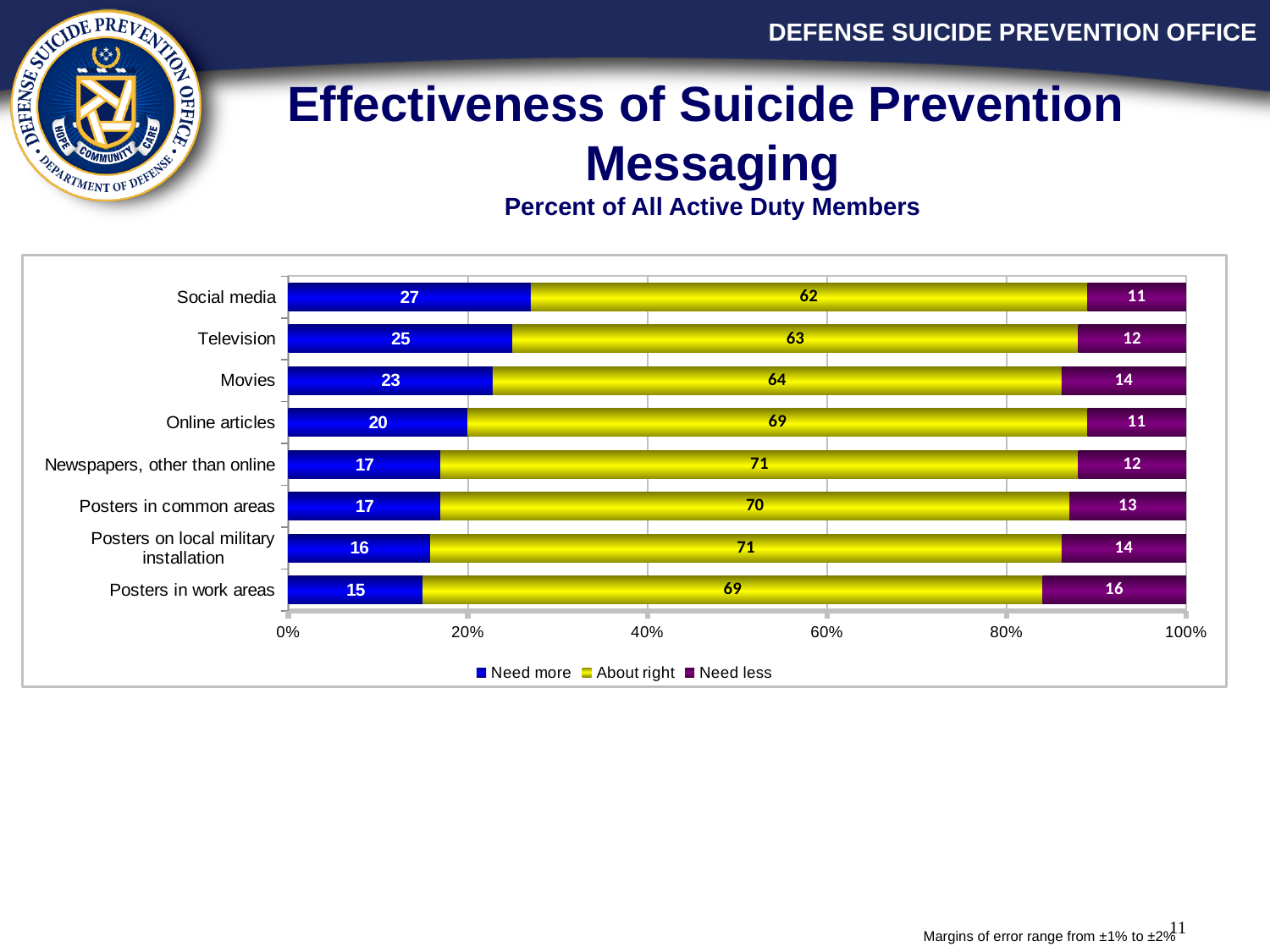
What is the 'About right' value for Newspapers, other than online? 71 Which is larger, the 'About right' value for Movies or for Online articles? Online articles What is the total of the stacked bar for Television? 100 Which category has the lowest 'Need more' value? Posters in work areas What kind of chart is shown on the slide? Stacked bar chart What is the 'Need more' value for Social media? 27 How many categories are shown on the chart? 8 What is the 'Need less' value for Posters in work areas? 16 What is the difference between the 'Need more' values for Social media and Posters in work areas? 12 What is the subtitle shown under the chart title? Percent of All Active Duty Members Which category has the highest 'Need more' value? Social media How many series does the legend list? 3